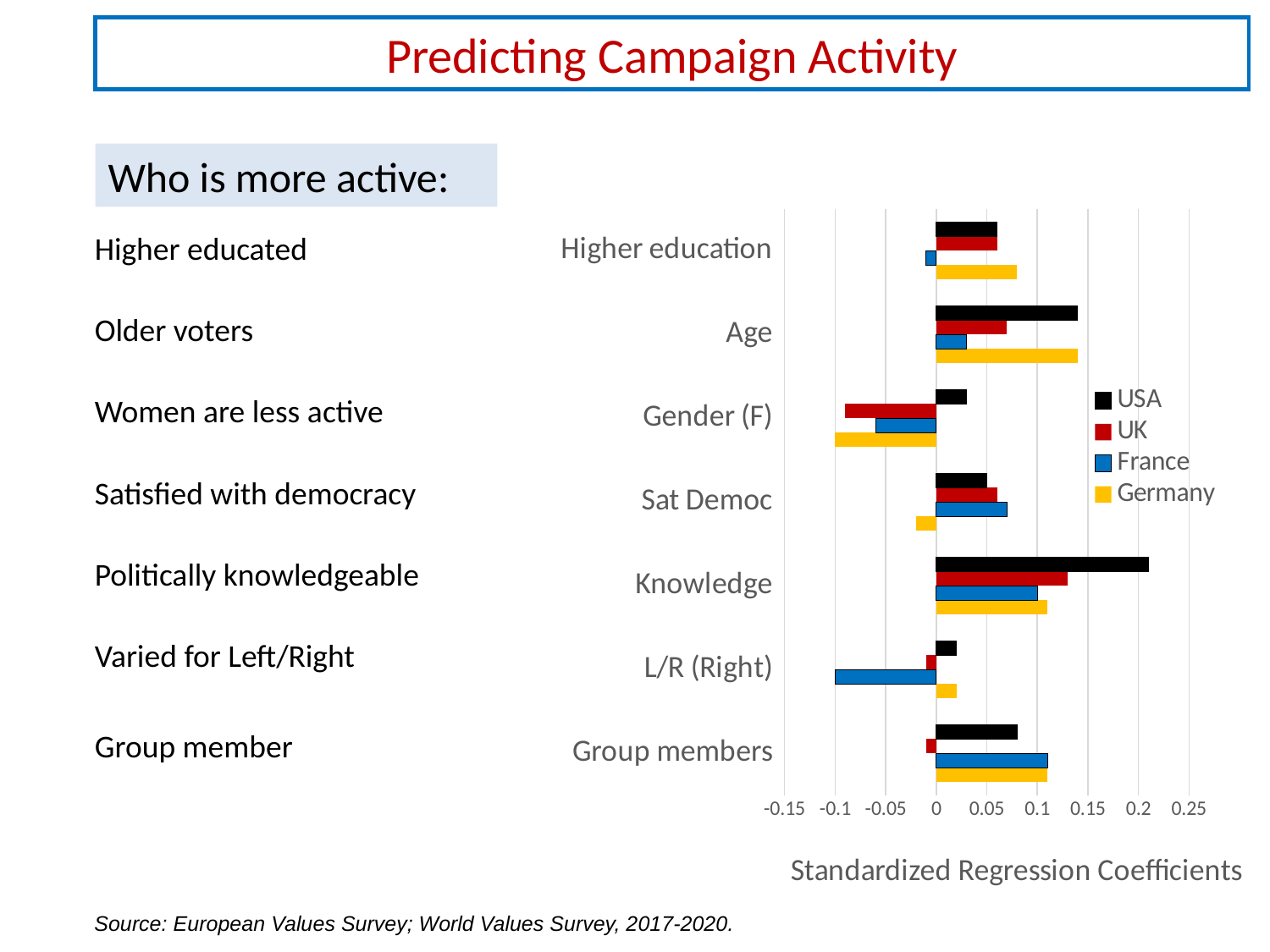
For Group members, which is larger: the France value or the UK value? France Is the France value for L/R (Right) greater or less than -0.05? less Is the Germany value for Age greater or less than 0.1? greater For Knowledge, which country has the highest value? USA How many series does the chart's legend list? 4 Which category has the highest USA value? Knowledge How many categories are plotted on the chart? 7 For Gender (F), which is larger: the USA value or the UK value? USA What is the label on the chart's horizontal axis? Standardized Regression Coefficients What kind of chart is shown on the slide? bar chart Is the Germany value for Sat Democ greater or less than 0? less